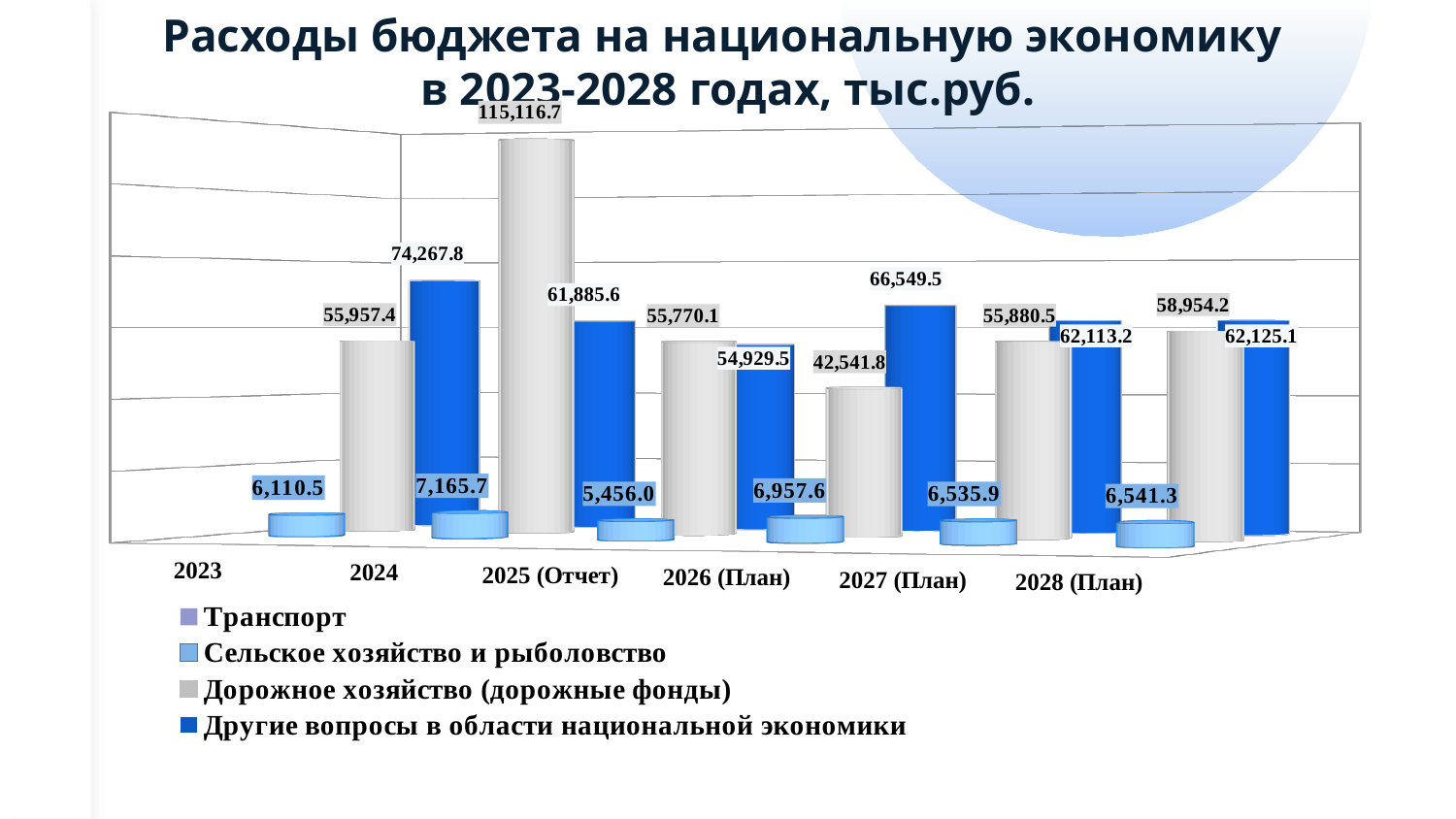
How many series does the legend list? 4 In 2026 (План), which is larger: Дорожное хозяйство (дорожные фонды) or Другие вопросы в области национальной экономики? Другие вопросы в области национальной экономики How many year categories are shown on the x axis? 6 In which year is the value for Сельское хозяйство и рыболовство the lowest? 2025 (Отчет) What is the difference between the values for Другие вопросы в области национальной экономики in 2023 and 2024? 12,382.2 What kind of chart is shown on the slide? Bar chart What is the value for Сельское хозяйство и рыболовство in 2025 (Отчет)? 5,456.0 In which year is the value for Другие вопросы в области национальной экономики the highest? 2023 What is the value for Другие вопросы в области национальной экономики in 2028 (План)? 62,125.1 What is the value for Дорожное хозяйство (дорожные фонды) in 2024? 115,116.7 What is the title of the chart? Расходы бюджета на национальную экономику в 2023-2028 годах, тыс.руб. In which year is the value for Дорожное хозяйство (дорожные фонды) the highest? 2024